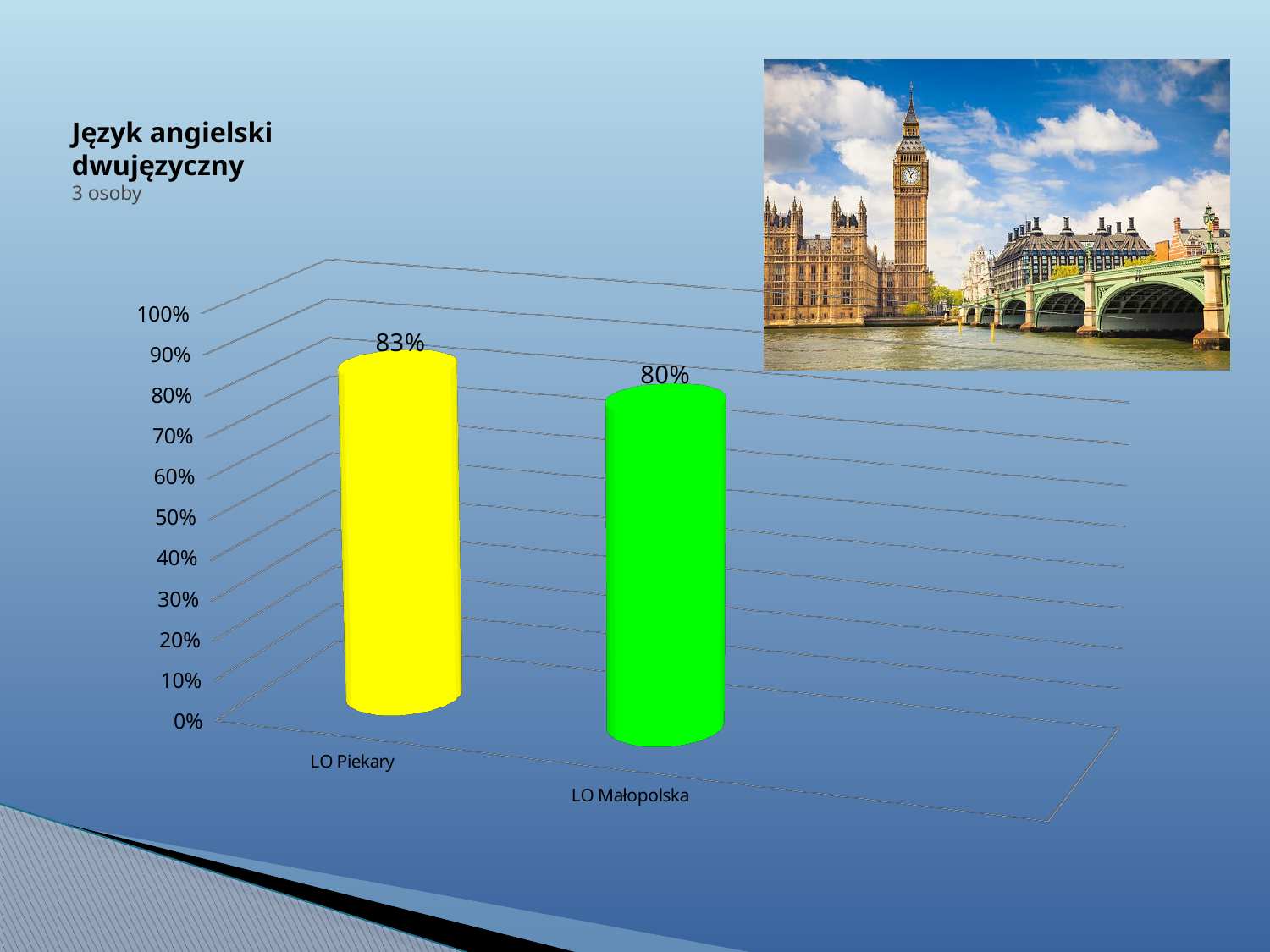
Which is larger, the value for LO Piekary or the value for LO Małopolska? LO Piekary What is the difference between the values for LO Piekary and LO Małopolska? 3% What colour is the bar for LO Małopolska? green Is the value for LO Małopolska greater or less than 50%? greater What is the highest value shown on the vertical axis? 100% How many categories are shown in the chart? 2 What is the value for LO Piekary? 83% Which category has the lowest value? LO Małopolska Which category has the highest value? LO Piekary What is the value for LO Małopolska? 80% What kind of chart is shown on the slide? bar chart